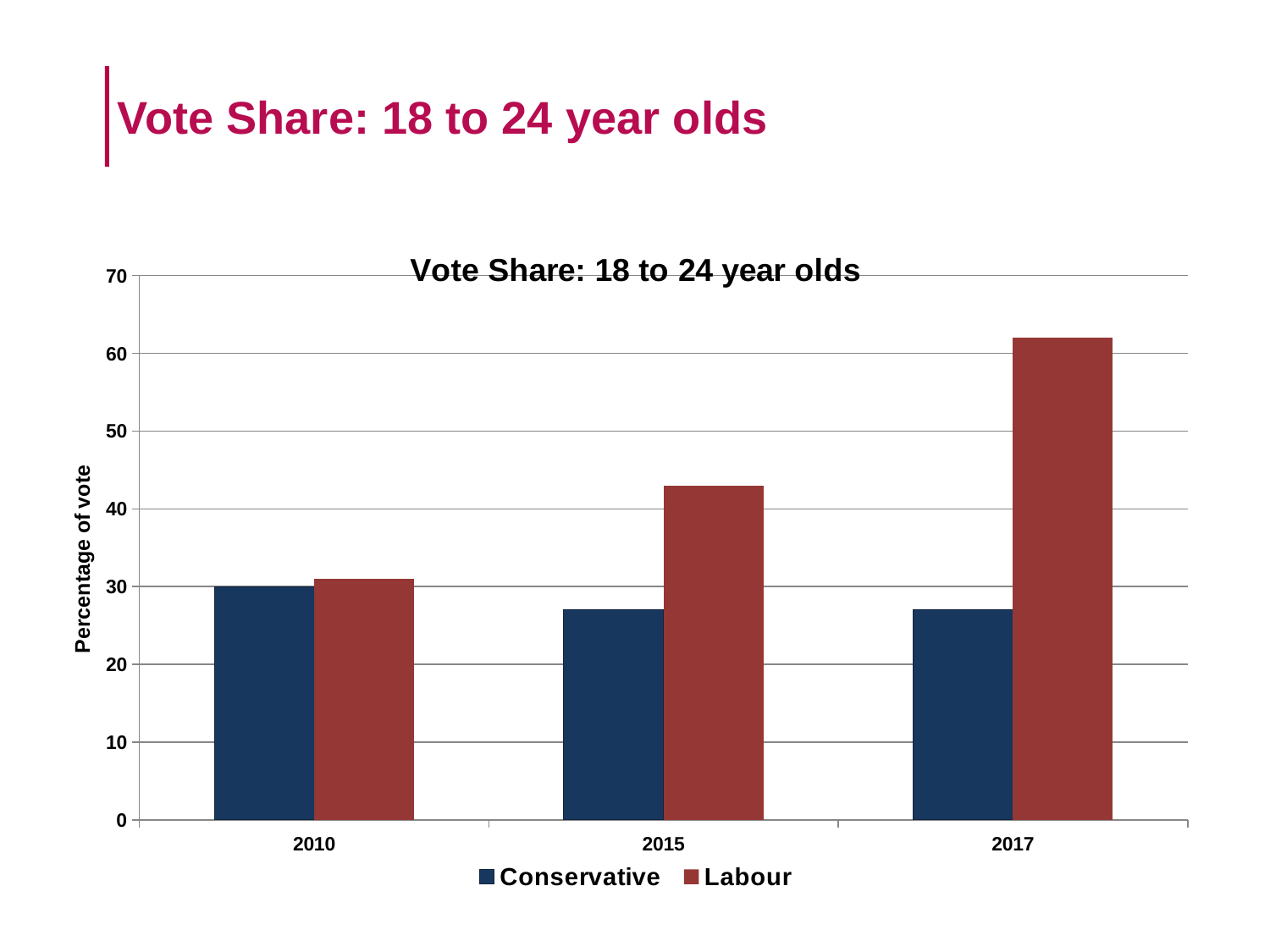
Which colour represents Labour in the chart's legend? red What kind of chart is shown on the slide? bar chart Is the Labour value for 2015 greater or less than 40? greater How many series does the chart's legend list? 2 In 2017, which is larger: the Conservative bar or the Labour bar? Labour Is the Conservative value for 2015 greater or less than 30? less Is the Labour value for 2017 greater or less than 50? greater Does the Labour vote share rise or fall from 2010 to 2017? rise How many years are shown on the x axis of the chart? 3 Which series and year has the highest bar in the chart? Labour in 2017 What is the label on the chart's vertical axis? Percentage of vote In 2015, which is larger: the Conservative bar or the Labour bar? Labour